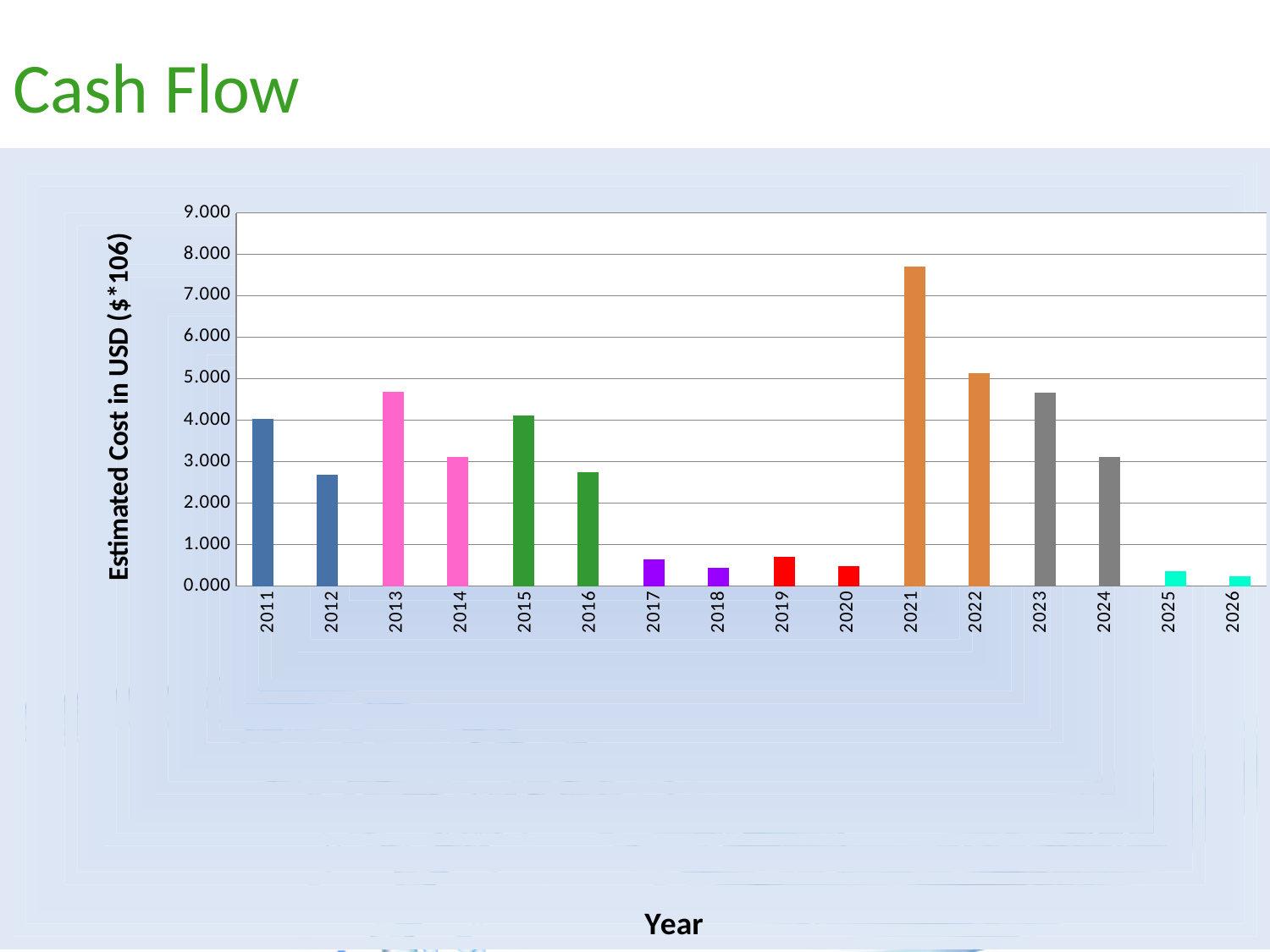
Which is larger, the value for 2015 or the value for 2016? 2015 Is the value for 2013 greater or less than 4.000? greater Do the values rise or fall from 2021 to 2026? fall Is the value for 2012 greater or less than 3.000? less Is the value for 2017 greater or less than 1.000? less Which is larger, the value for 2021 or the value for 2022? 2021 Which year has the highest estimated cost? 2021 How many years are plotted on the x axis? 16 What kind of chart is shown on the slide? bar chart What is the title of the x axis? Year